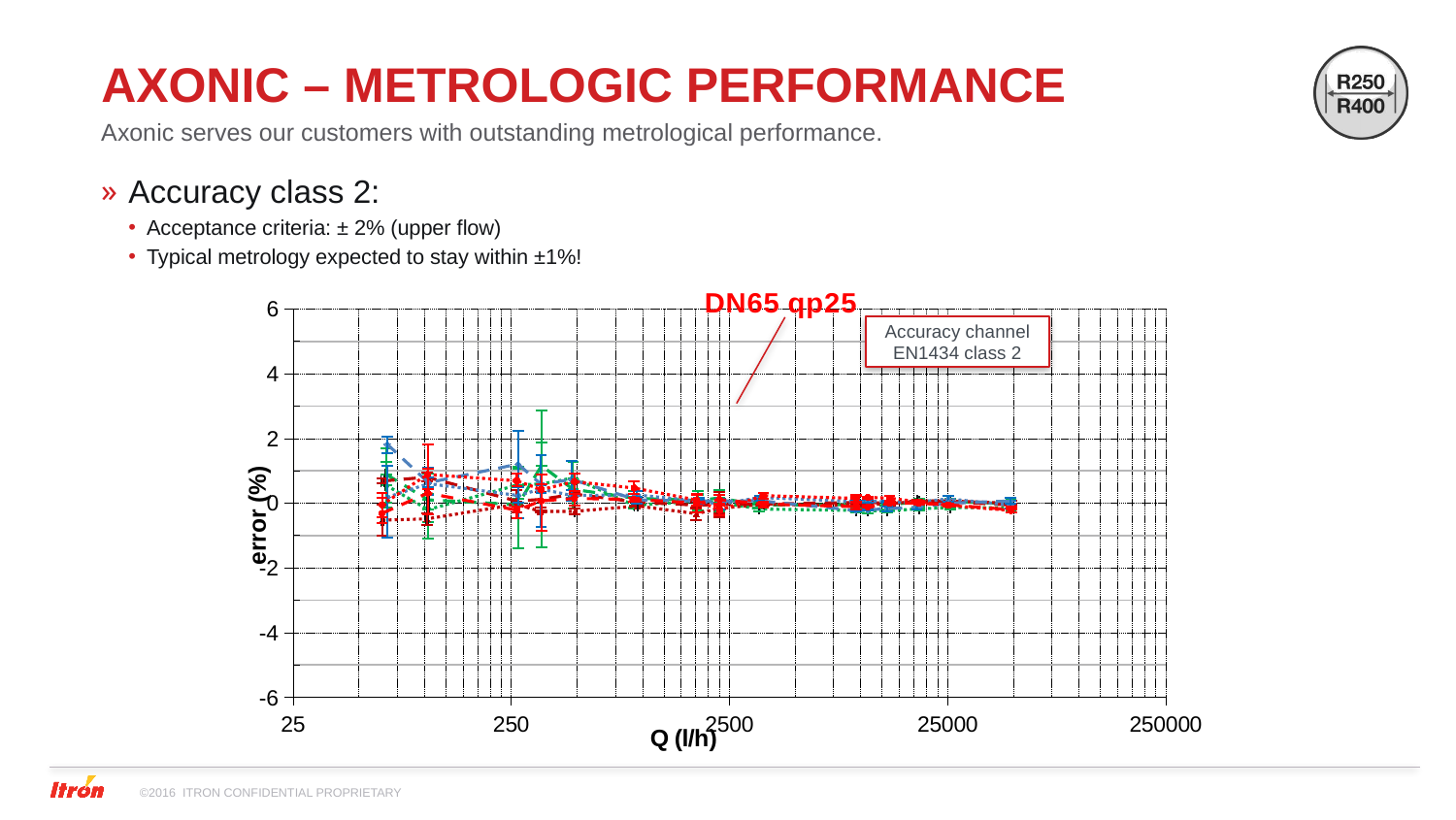
Is the error value at Q = 25000 l/h greater or less than 2? less What kind of chart is shown on the slide? line chart Is the error value at Q = 2500 l/h greater or less than -2? greater Is the error value at Q = 250 l/h greater or less than 4? less Do the plotted error values move closer to 0 or further from 0 as Q increases? closer to 0 Does the spread of the error values get larger or smaller as Q increases along the x axis? smaller What is the title of the chart? DN65 qp25 What is the label of the y axis of the chart? error (%)